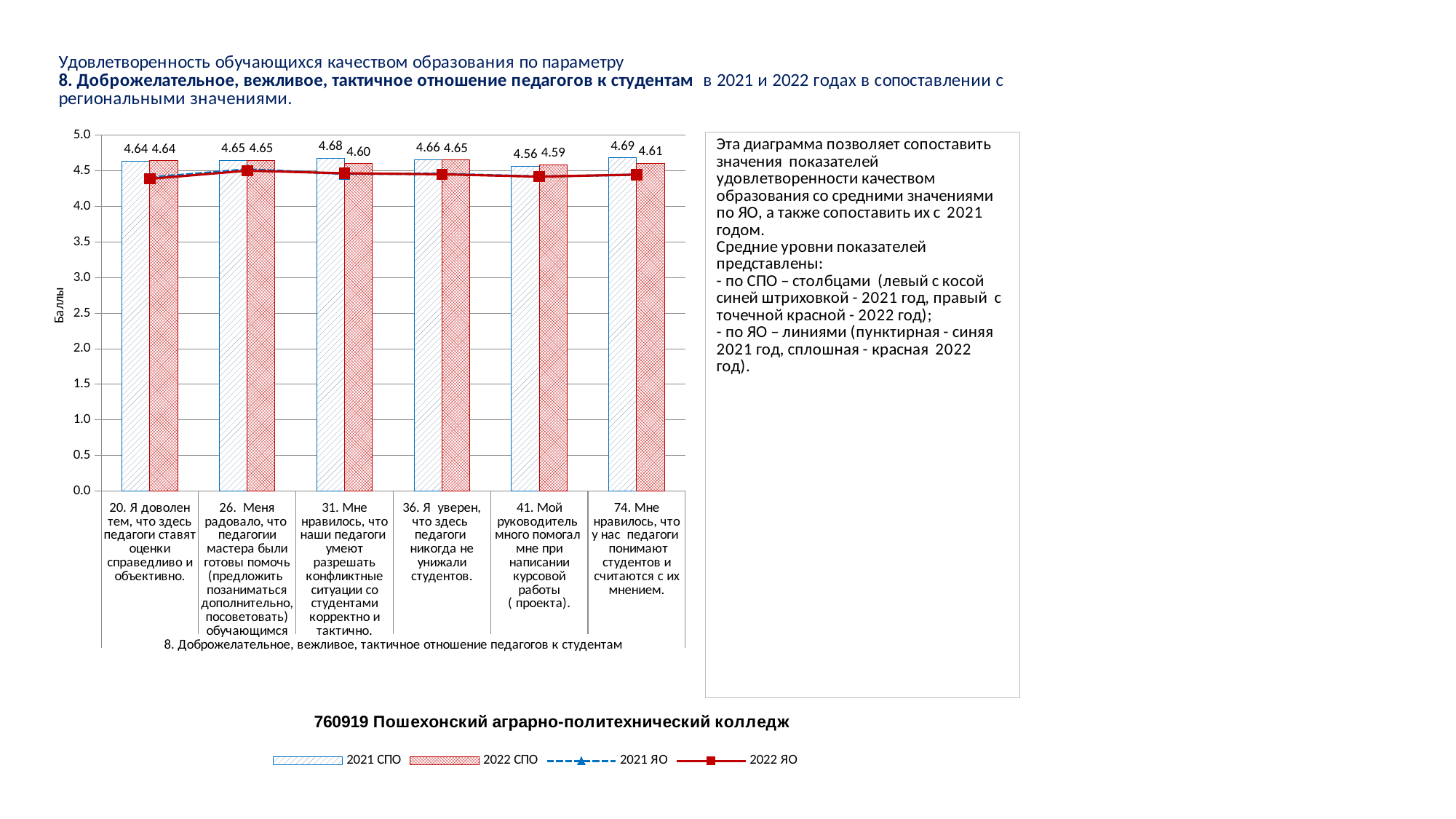
What is the value of the 2021 СПО bar for item 20 (Я доволен тем, что здесь педагоги ставят оценки справедливо и объективно)? 4.64 What is the difference between the 2021 СПО and 2022 СПО values for item 31? 0.08 What is the value of the 2022 СПО bar for item 41 (Мой руководитель много помогал мне при написании курсовой работы)? 4.59 How many items (categories) are shown on the x axis of the chart? 6 For item 74, which is larger: the 2021 СПО value or the 2022 СПО value? 2021 СПО (4.69) What is the value of the 2022 СПО bar for item 31 (Мне нравилось, что наши педагоги умеют разрешать конфликтные ситуации...)? 4.60 Is the 2022 ЯО line value for item 20 greater or less than 4.5? less Which item has the highest 2021 СПО bar? 74. Мне нравилось, что у нас педагоги понимают студентов и считаются с их мнением (4.69) For item 41, which is larger: the 2021 СПО value or the 2022 СПО value? 2022 СПО (4.59) Which item has the lowest 2021 СПО bar? 41. Мой руководитель много помогал мне при написании курсовой работы (4.56) How many series does the chart legend list? 4 What is the difference between the 2022 СПО and 2021 СПО values for item 41? 0.03